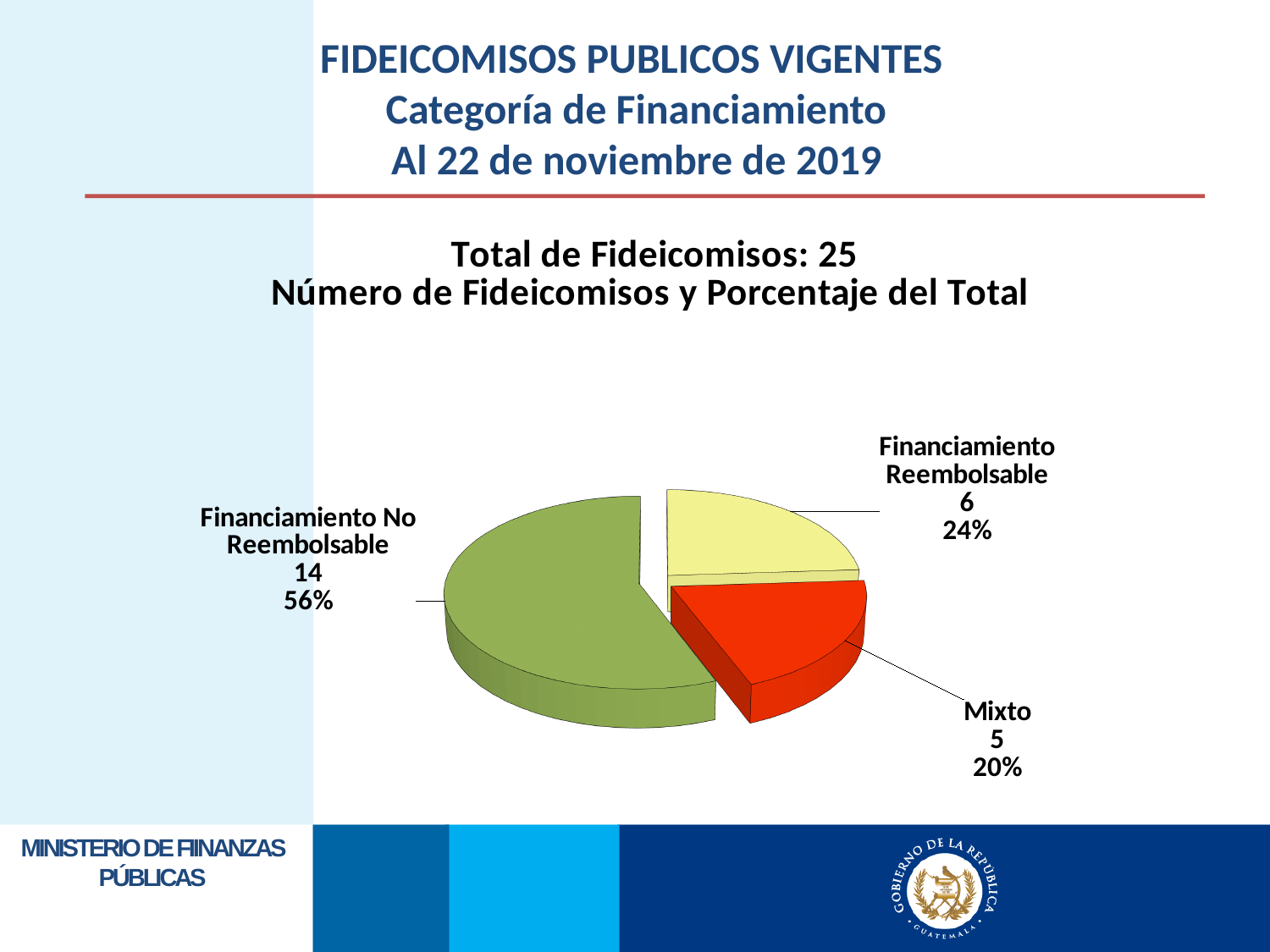
How many fideicomisos are in the Financiamiento No Reembolsable category? 14 How many categories does the pie chart show? 3 What colour is the Mixto slice of the pie chart? Red What is the total number of fideicomisos stated on the slide? 25 What kind of chart is shown on the slide? Pie chart What is the difference in the number of fideicomisos between Financiamiento No Reembolsable and Financiamiento Reembolsable? 8 What percentage of the total does Financiamiento Reembolsable represent? 24% Which category has the largest number of fideicomisos? Financiamiento No Reembolsable Which category has the smallest number of fideicomisos? Mixto How many fideicomisos are in the Mixto category? 5 Which has more fideicomisos, Financiamiento Reembolsable or Mixto? Financiamiento Reembolsable What percentage of the total does Mixto represent? 20%